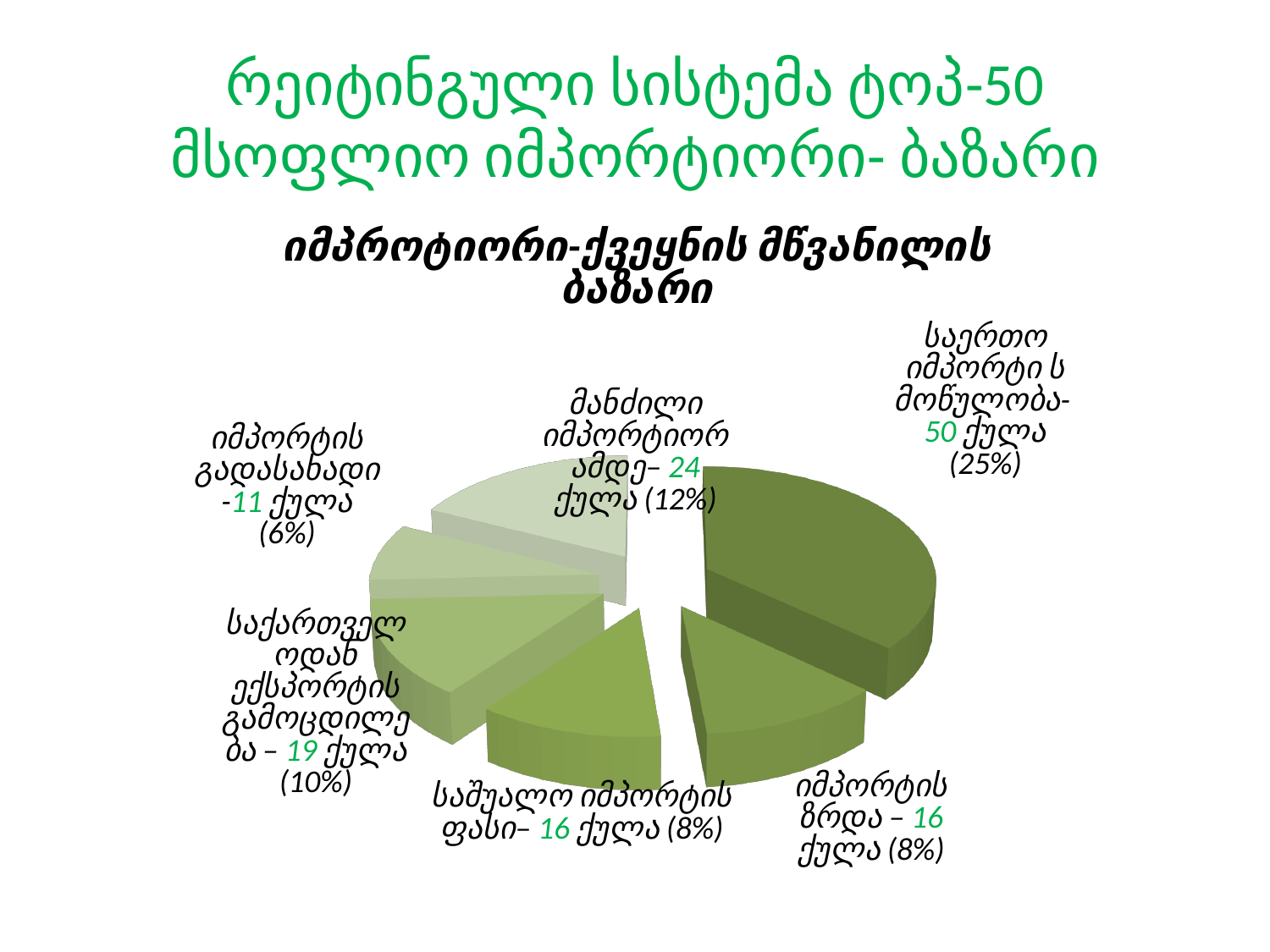
Which category has the smallest slice of the pie? იმპორტის გადასახადი What percentage is shown for "იმპორტის ზრდა"? 8% What is the title of the pie chart? იმპროტიორი-ქვეყნის მწვანილის ბაზარი Which category has the largest slice of the pie? საერთო იმპორტის მოცულობა How many labeled categories does the pie chart show? 6 How many points does "მანძილი იმპორტიორამდე" have? 24 ქულა How many points (ქულა) does the slice "საერთო იმპორტის მოცულობა" have? 50 ქულა What kind of chart is shown on the slide? pie chart What is the difference in points between "საერთო იმპორტის მოცულობა" and "მანძილი იმპორტიორამდე"? 26 What share of the pie does "საერთო იმპორტის მოცულობა" represent? 25% What percentage is shown for "საქართველოდან ექსპორტის გამოცდილება"? 10% Which has more points: "საქართველოდან ექსპორტის გამოცდილება" or "საშუალო იმპორტის ფასი"? საქართველოდან ექსპორტის გამოცდილება